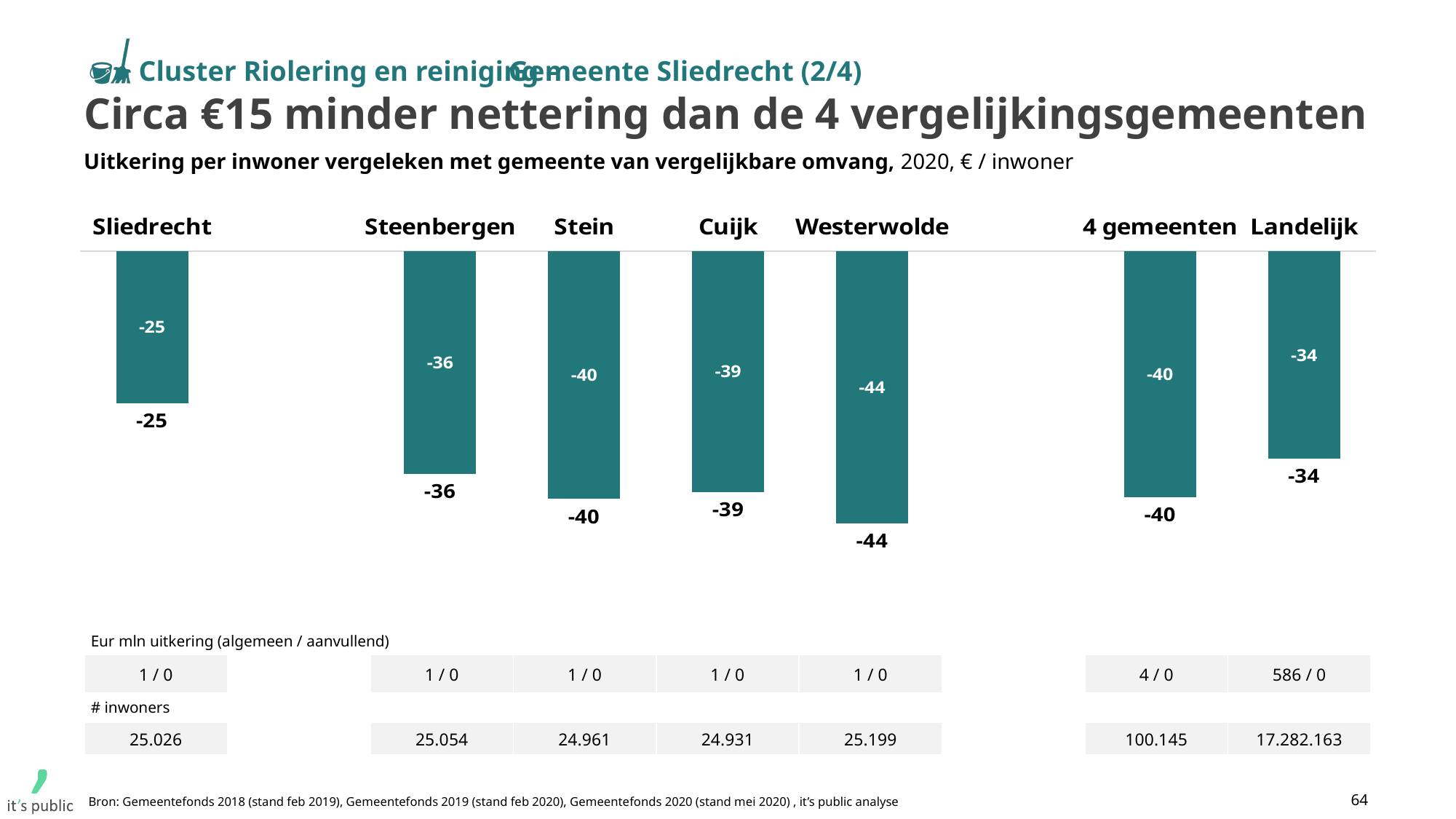
Which category has the highest (least negative) value? Sliedrecht Which has the larger (less negative) value, Stein or Cuijk? Cuijk What is the value for Sliedrecht? -25 What unit is stated in the chart subtitle? € / inwoner How many bars are shown in the chart? 7 What is the difference between the value for Sliedrecht and the value for 4 gemeenten? 15 What is the value for 4 gemeenten? -40 Which category has the lowest (most negative) value? Westerwolde What is the difference between the value for Westerwolde and the value for Steenbergen? 8 What kind of chart is shown on the slide? Bar chart What is the value for Westerwolde? -44 What is the value for Landelijk? -34